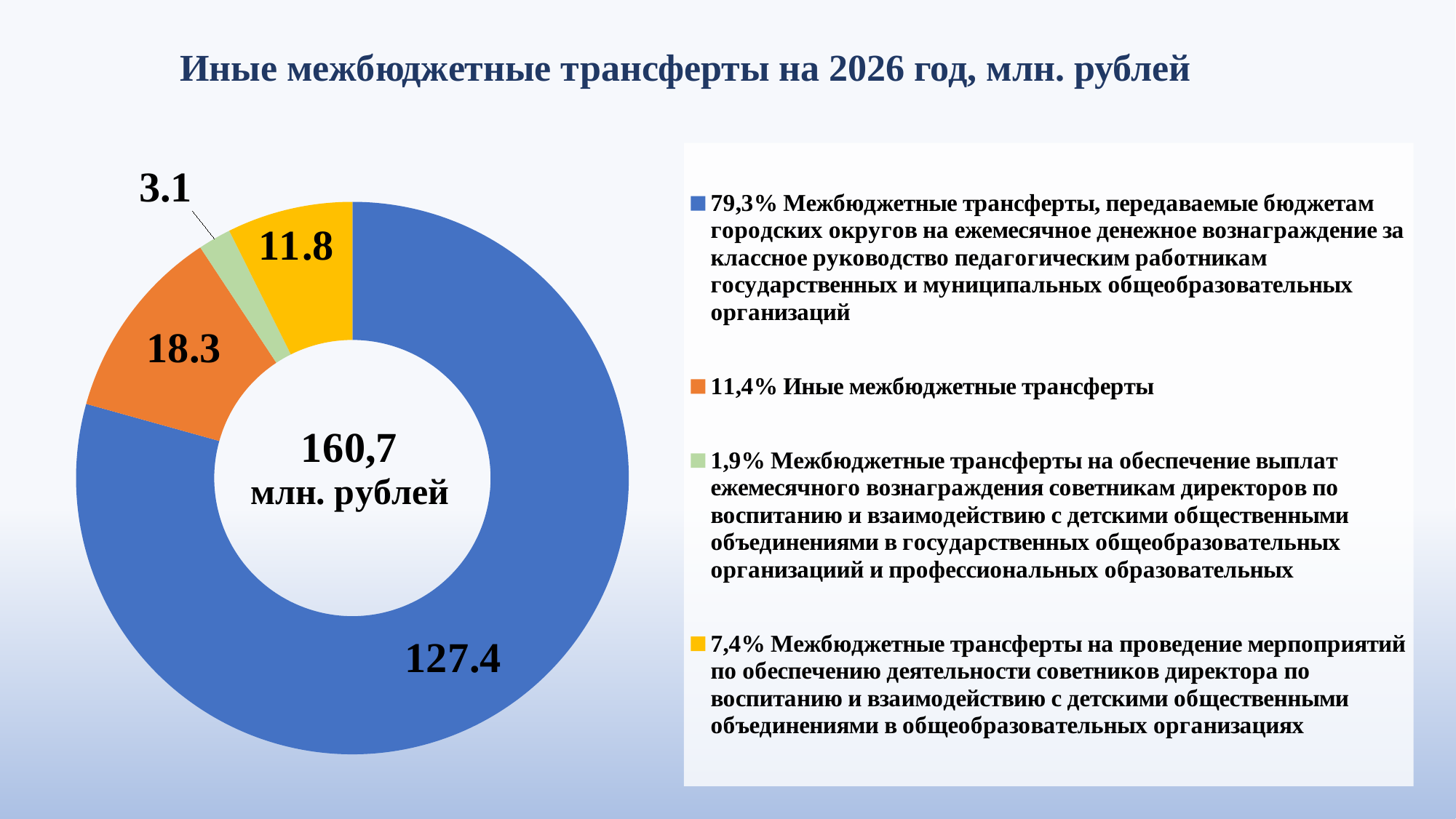
What is the value of the green slice (transfers for monthly remuneration of advisers to directors)? 3.1 What share of the total does the slice "Иные межбюджетные трансферты" represent, according to the legend? 11,4% How many slices does the doughnut chart have? 4 What type of chart is shown on the slide? Doughnut (pie) chart Which category has the largest value in the chart? Межбюджетные трансферты на ежемесячное денежное вознаграждение за классное руководство (127.4) What is the value of the yellow slice (transfers for events supporting the activities of advisers to the director)? 11.8 Which category has the smallest value in the chart? Межбюджетные трансферты на обеспечение выплат ежемесячного вознаграждения советникам директоров (3.1) What is the value of the largest slice, for transfers for monthly payments for class leadership (классное руководство)? 127.4 What total value is shown in the centre of the doughnut chart? 160,7 млн. рублей What is the value for the slice labelled "Иные межбюджетные трансферты" (orange)? 18.3 Which is larger: the orange slice "Иные межбюджетные трансферты" or the yellow slice for events supporting advisers to the director? Иные межбюджетные трансферты (18.3) What is the difference between the largest slice (127.4) and the slice for "Иные межбюджетные трансферты" (18.3)? 109.1